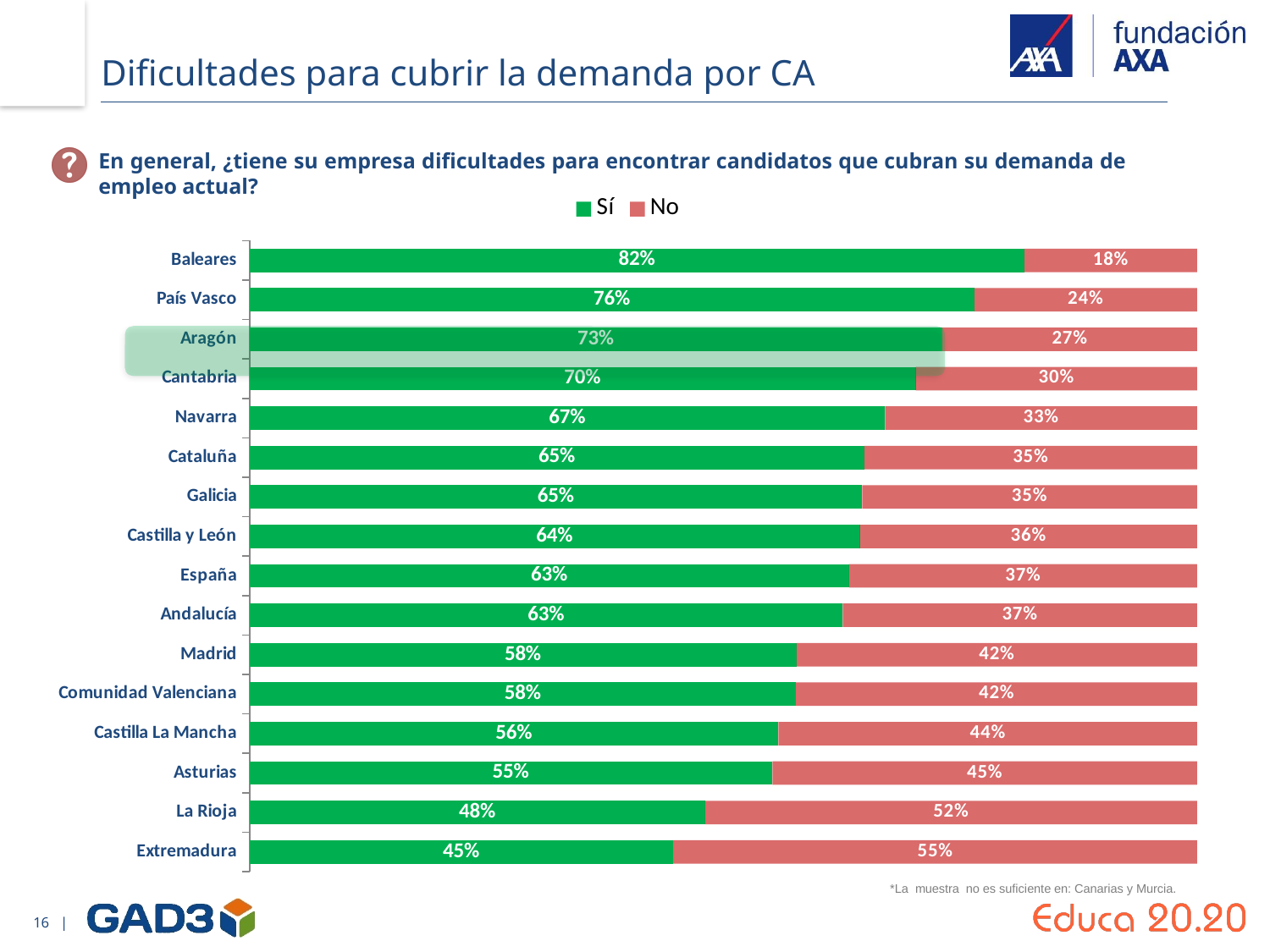
Which region has the highest 'Sí' value? Baleares What is the 'Sí' value for España? 63% What is the difference between the 'Sí' values for País Vasco and Madrid? 18% What is the 'Sí' value for Baleares? 82% What is the 'No' value for Aragón? 27% How many regions (categories) are shown in the chart? 16 Which region has the lowest 'Sí' value? Extremadura What is the 'No' value for Extremadura? 55% How many series does the legend list? 2 What kind of chart is shown on the slide? Stacked bar chart Which has a larger 'Sí' value, Navarra or Asturias? Navarra What is the total of the 'Sí' and 'No' values for La Rioja? 100%